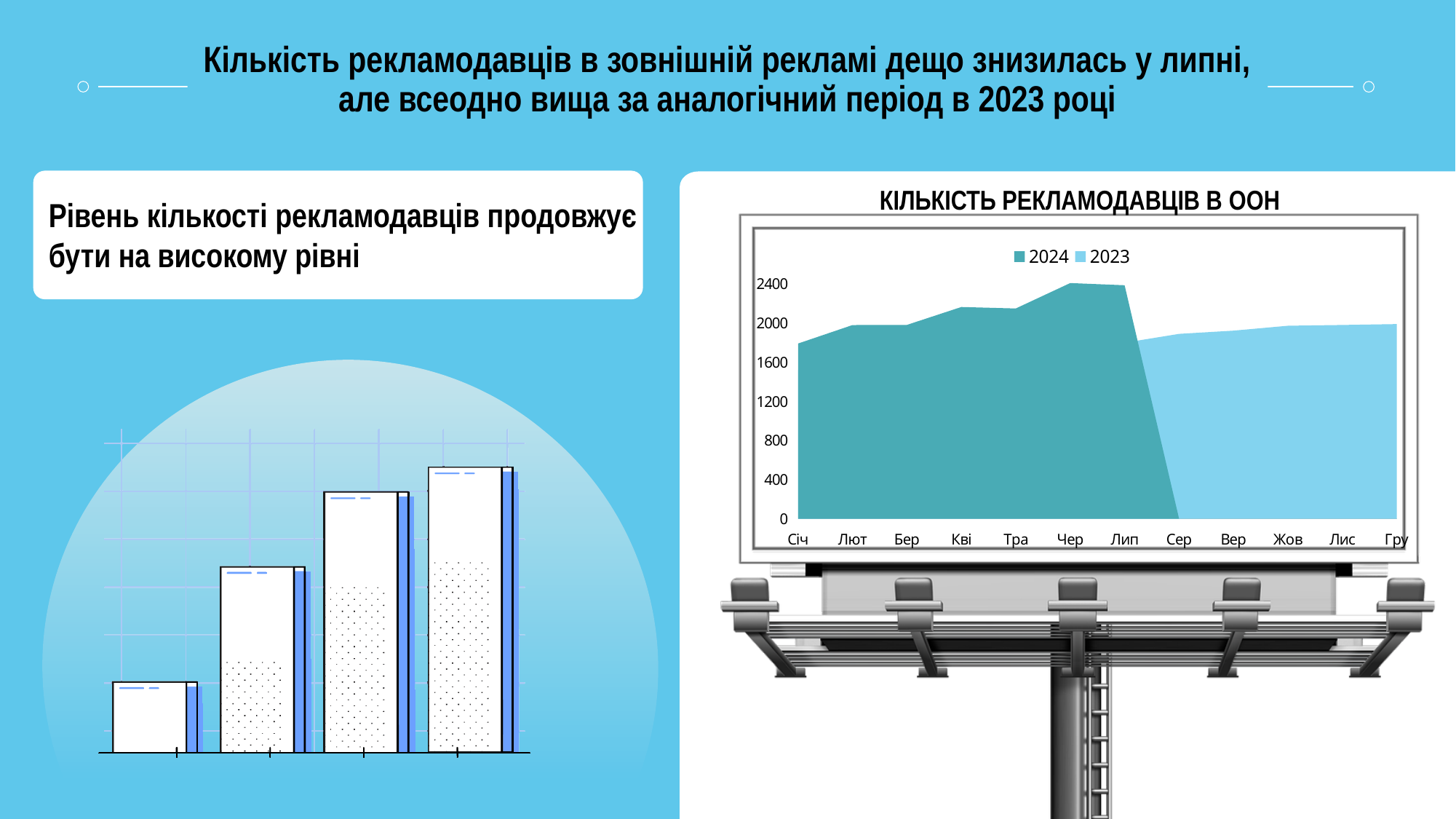
What kind of chart is shown on the billboard on the right? area chart In the chart "КІЛЬКІСТЬ РЕКЛАМОДАВЦІВ В ООН", is the 2024 value for Січ greater or less than 1600? greater In the chart "КІЛЬКІСТЬ РЕКЛАМОДАВЦІВ В ООН", is the 2024 value for Чер greater or less than 2000? greater What is the title of the chart on the billboard? КІЛЬКІСТЬ РЕКЛАМОДАВЦІВ В ООН What is the highest value labelled on the y axis of the chart "КІЛЬКІСТЬ РЕКЛАМОДАВЦІВ В ООН"? 2400 In the chart "КІЛЬКІСТЬ РЕКЛАМОДАВЦІВ В ООН", is the 2023 value for Сер greater or less than 2000? less How many series does the legend of the chart "КІЛЬКІСТЬ РЕКЛАМОДАВЦІВ В ООН" list? 2 In the chart "КІЛЬКІСТЬ РЕКЛАМОДАВЦІВ В ООН", does the 2024 series generally rise or fall from Січ to Чер? rise How many months are shown on the x axis of the chart "КІЛЬКІСТЬ РЕКЛАМОДАВЦІВ В ООН"? 12 In the chart "КІЛЬКІСТЬ РЕКЛАМОДАВЦІВ В ООН", which month has the lowest 2024 value among the months where 2024 is shown? Січ In the chart "КІЛЬКІСТЬ РЕКЛАМОДАВЦІВ В ООН", which is larger: the 2024 value for Чер or the 2024 value for Січ? Чер